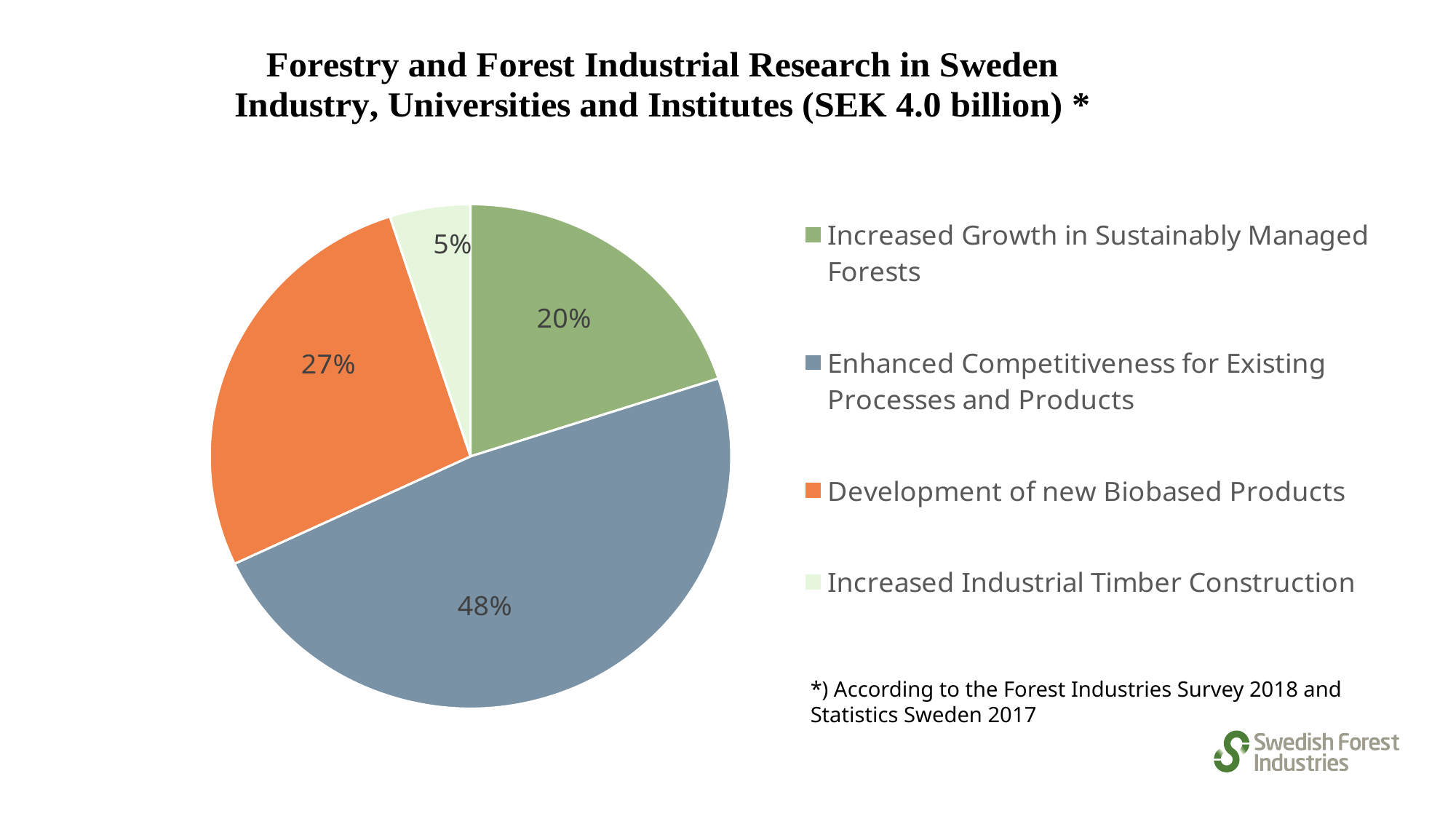
What is the total amount of research spending given in the chart title? SEK 4.0 billion What share of the pie is Increased Industrial Timber Construction? 5% What share of the pie is Increased Growth in Sustainably Managed Forests? 20% Which is larger: the share for Development of new Biobased Products or the share for Increased Growth in Sustainably Managed Forests? Development of new Biobased Products Which category has the smallest slice of the pie? Increased Industrial Timber Construction How many slices does the pie chart have? 4 What share of the pie is Enhanced Competitiveness for Existing Processes and Products? 48% What colour is the slice for Development of new Biobased Products? Orange Which category has the largest slice of the pie? Enhanced Competitiveness for Existing Processes and Products What is the difference in percentage points between Enhanced Competitiveness for Existing Processes and Products and Development of new Biobased Products? 21 percentage points What type of chart is shown on the slide? Pie chart